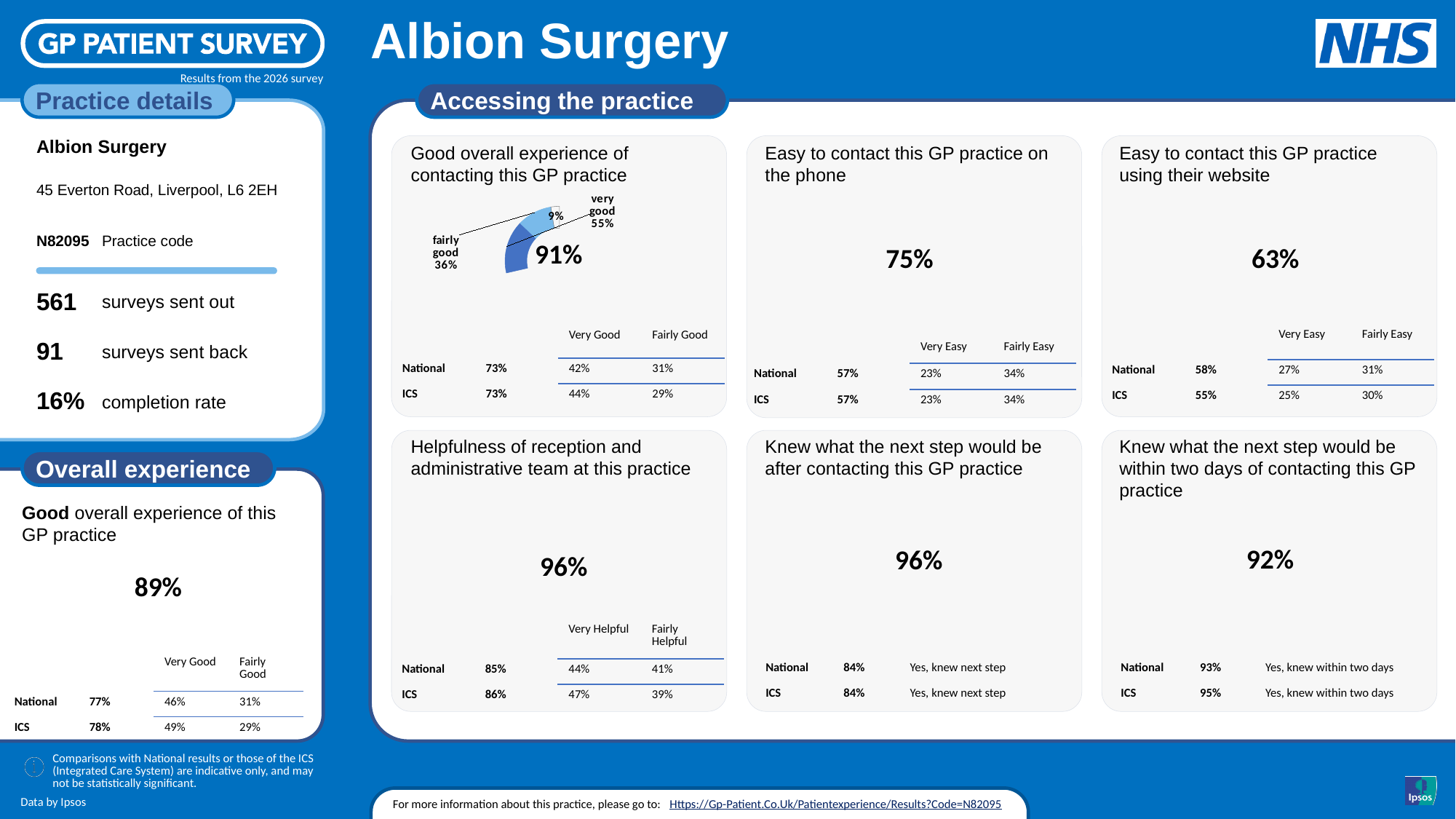
In the chart for 'Good overall experience of contacting this GP practice', what is the smallest percentage shown on any slice? 9% In the chart for 'Good overall experience of contacting this GP practice', which is larger, 'very good' or 'fairly good'? very good What kind of chart is used in the 'Good overall experience of contacting this GP practice' panel? doughnut chart How many slices with data labels are shown in the chart for 'Good overall experience of contacting this GP practice'? 3 In the chart for 'Good overall experience of contacting this GP practice', what is the difference between the 'very good' and 'fairly good' percentages? 19% In the chart for 'Good overall experience of contacting this GP practice', is the 'very good' share greater or less than 50%? greater In the chart for 'Good overall experience of contacting this GP practice', what percentage is shown for 'fairly good'? 36% In the chart for 'Good overall experience of contacting this GP practice', which labelled slice is the largest? very good In the chart for 'Good overall experience of contacting this GP practice', what is the combined percentage of 'very good' and 'fairly good'? 91% What large number is printed in the centre of the chart for 'Good overall experience of contacting this GP practice'? 91% In the chart for 'Good overall experience of contacting this GP practice', what percentage is shown for 'very good'? 55% What is the title of the panel containing the only chart on the slide? Good overall experience of contacting this GP practice